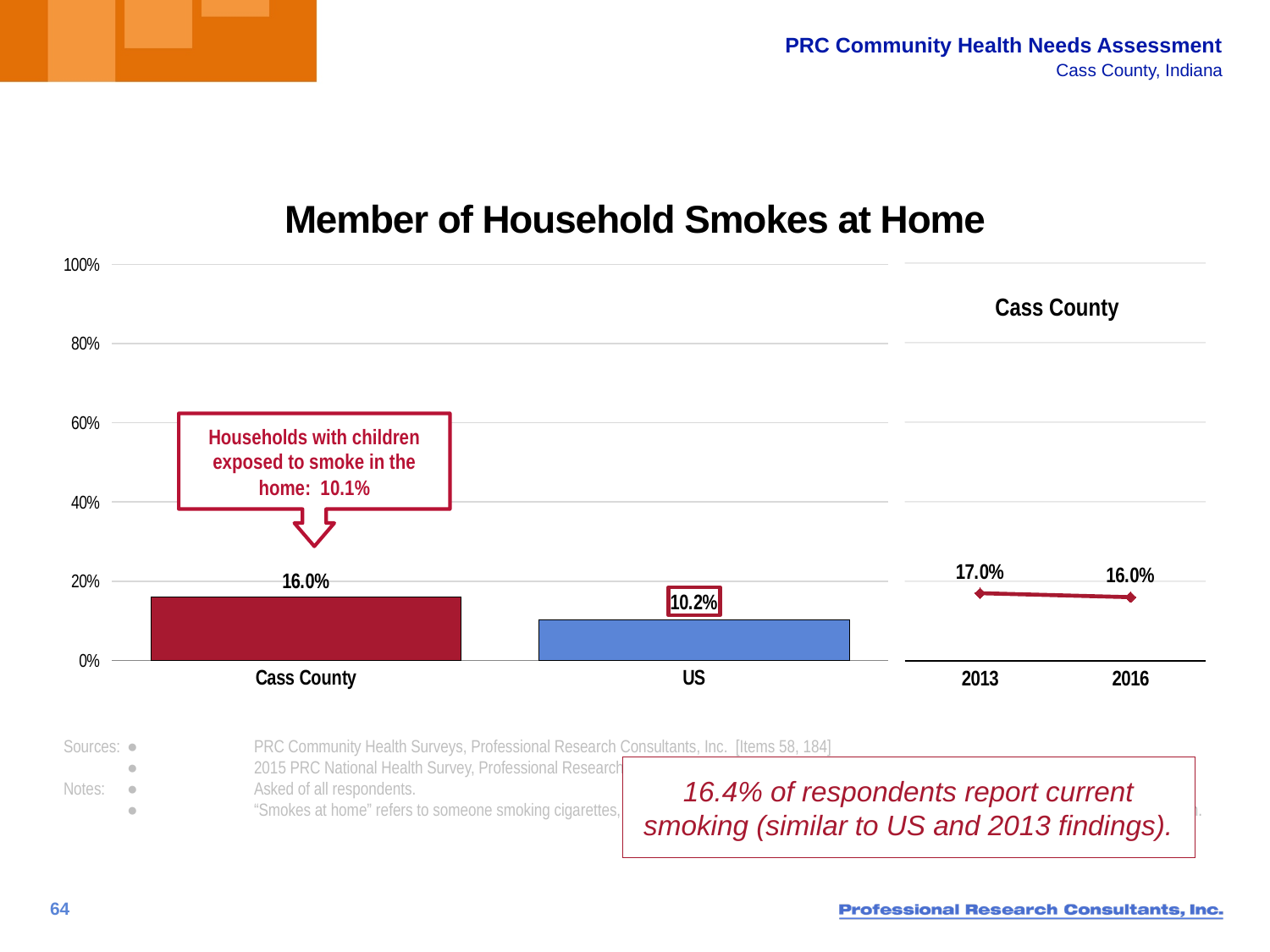
In the Cass County trend chart on the right, what is the value for 2016? 16.0% What is the title of the chart on the slide? Member of Household Smokes at Home In the bar chart on the left, what is the value for US? 10.2% In the bar chart on the left, what is the value for Cass County? 16.0% What kind of chart is shown on the left side of the slide? bar chart How many bars are in the bar chart on the left? 2 In the Cass County trend chart on the right, what is the value for 2013? 17.0% In the bar chart on the left, is the value for Cass County greater or less than 20%? less In the bar chart on the left, which category has the higher value, Cass County or US? Cass County In the Cass County trend chart on the right, do the values rise or fall from 2013 to 2016? fall In the Cass County trend chart on the right, what is the difference between the 2013 and 2016 values? 1.0 percentage point In the bar chart on the left, what is the difference between the Cass County value and the US value? 5.8 percentage points